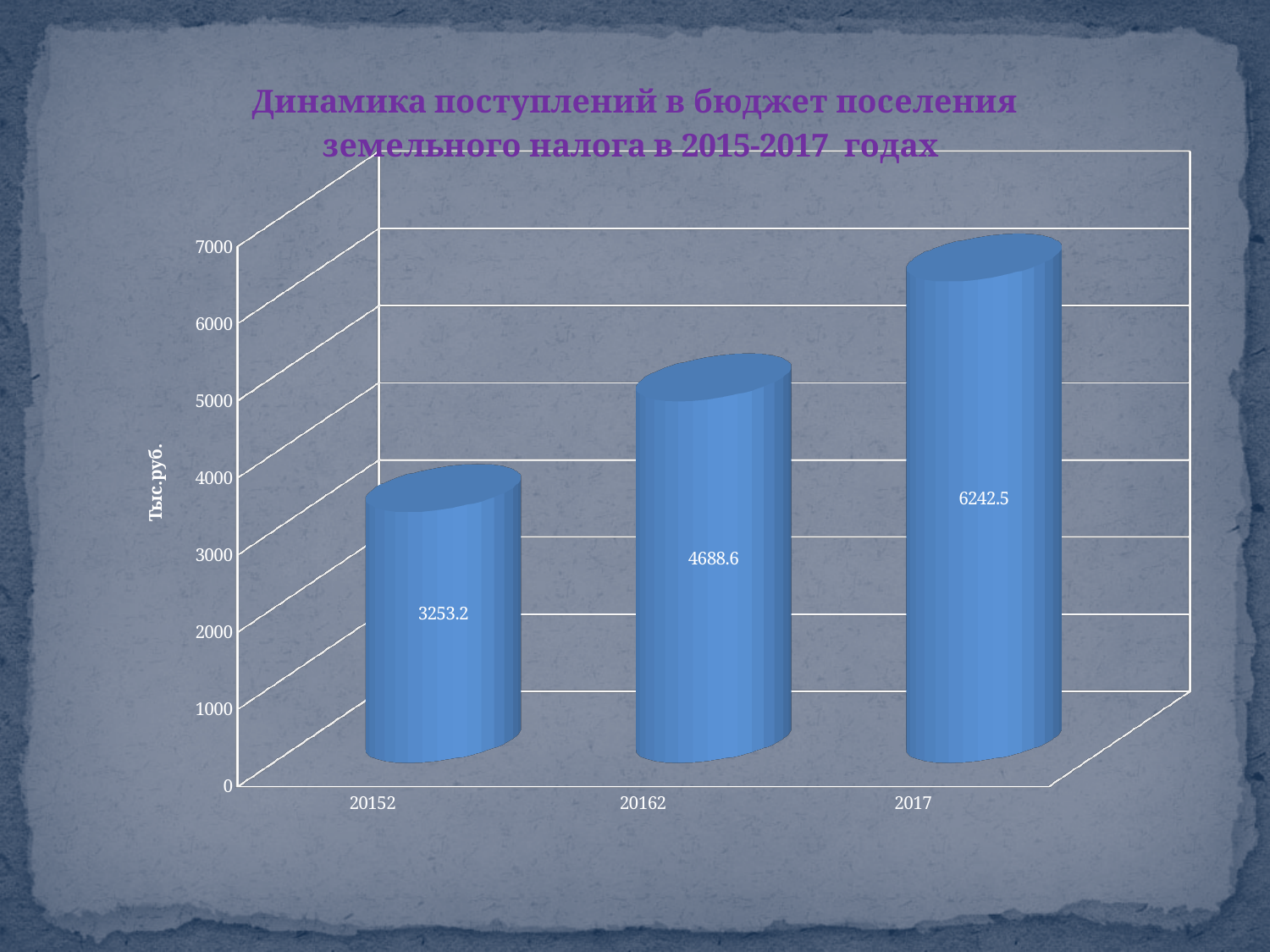
How many bars are shown in the chart? 3 What is the value of the bar labelled 2017? 6242.5 Which category has the lowest value? 20152 What is the value of the middle bar (labelled 20162)? 4688.6 What kind of chart is shown on the slide? Bar chart What is the difference between the value for 2017 and the value for the middle bar (20162)? 1553.9 Which category has the highest value? 2017 Is the value for 2017 greater or less than 6000? greater Which is larger, the value for 2017 or the value for the first bar (20152)? 2017 What is the value of the first bar (labelled 20152)? 3253.2 Do the values rise or fall from left to right along the x axis? Rise What is the difference between the value for the middle bar (20162) and the first bar (20152)? 1435.4